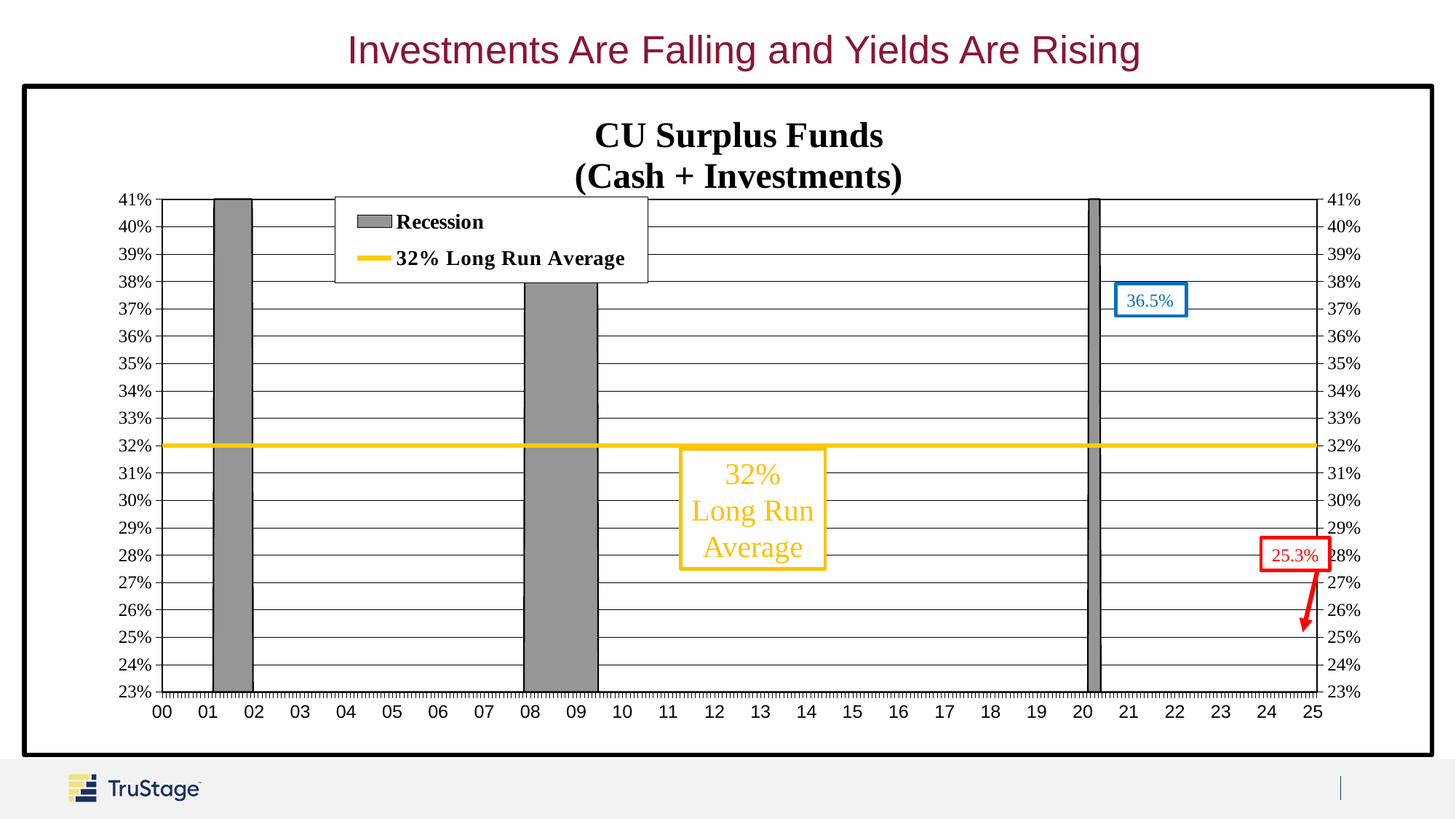
Is the 25.3% callout value greater or less than the 32% long run average? less How many entries does the chart legend list? 2 How many year labels are shown on the x axis? 26 What colour are the recession bars in the chart? Gray What value is the long run average line drawn at? 32% What is the difference between the 36.5% callout value and the 25.3% callout value? 11.2% How many shaded recession bars are shown on the chart? 3 Is the 36.5% callout value greater or less than the 32% long run average? greater What is the title of the chart? CU Surplus Funds (Cash + Investments) What value is shown in the blue callout box near year 21? 36.5% Which is larger, the value in the blue callout (36.5%) or the value in the red callout (25.3%)? 36.5% What value is shown in the red callout box near year 25? 25.3%